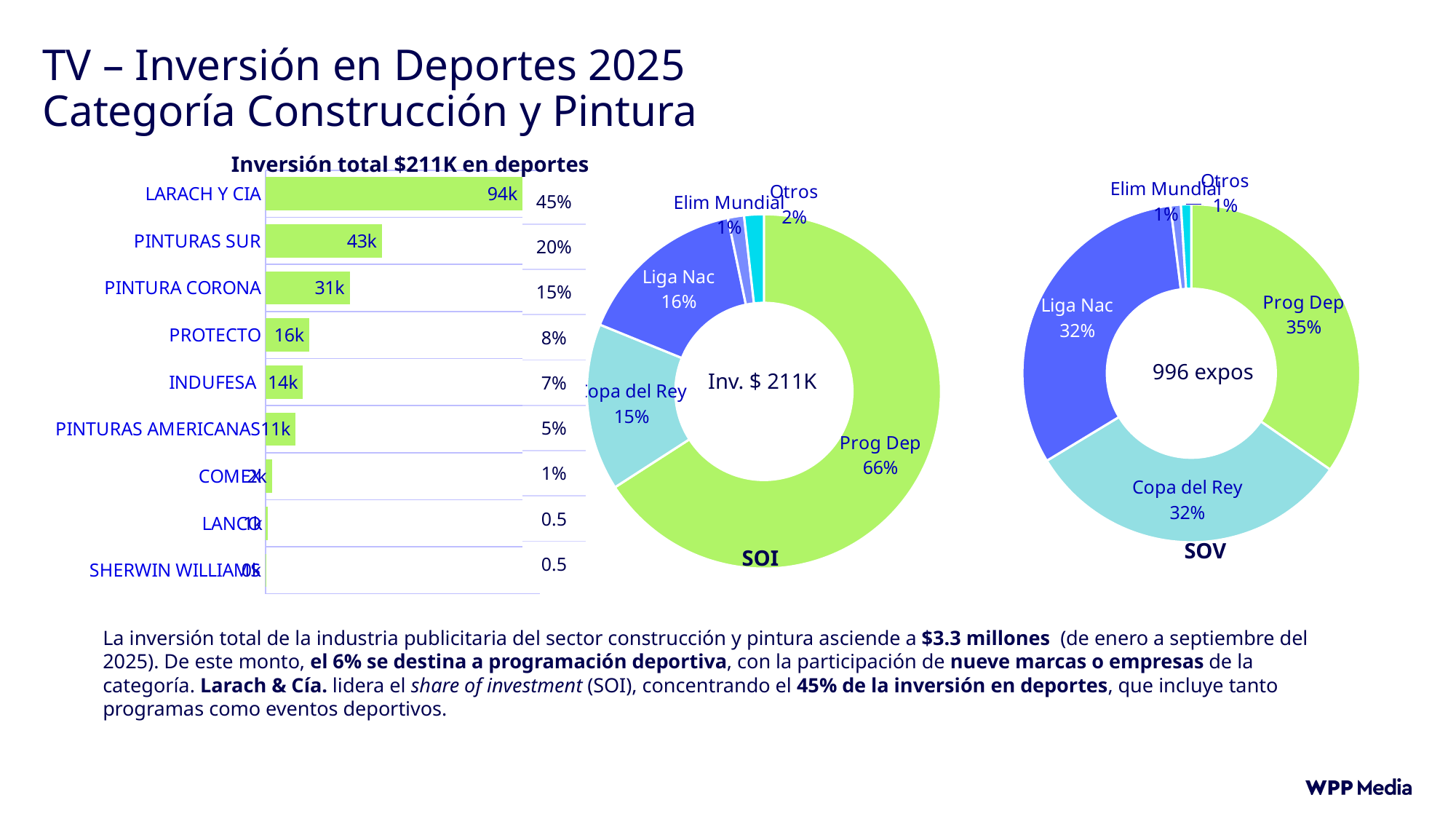
In the SOV donut chart, what share does Copa del Rey have? 32% In the bar chart 'Inversión total $211K en deportes', what is the difference between PINTURAS SUR and PROTECTO? 27k How many companies are listed in the bar chart 'Inversión total $211K en deportes'? 9 What type of chart is 'Inversión total $211K en deportes'? Bar chart In the bar chart 'Inversión total $211K en deportes', what is the value for PINTURA CORONA? 31k In the SOI donut chart, what share does Prog Dep have? 66% In the SOV donut chart, which segment is the largest? Prog Dep In the SOI donut chart, what share does Liga Nac have? 16% In the bar chart 'Inversión total $211K en deportes', which is larger, INDUFESA or PINTURAS AMERICANAS? INDUFESA In the bar chart 'Inversión total $211K en deportes', what is the value for LARACH Y CIA? 94k In the bar chart 'Inversión total $211K en deportes', which company has the highest investment? LARACH Y CIA What text is shown in the centre of the SOV donut chart? 996 expos